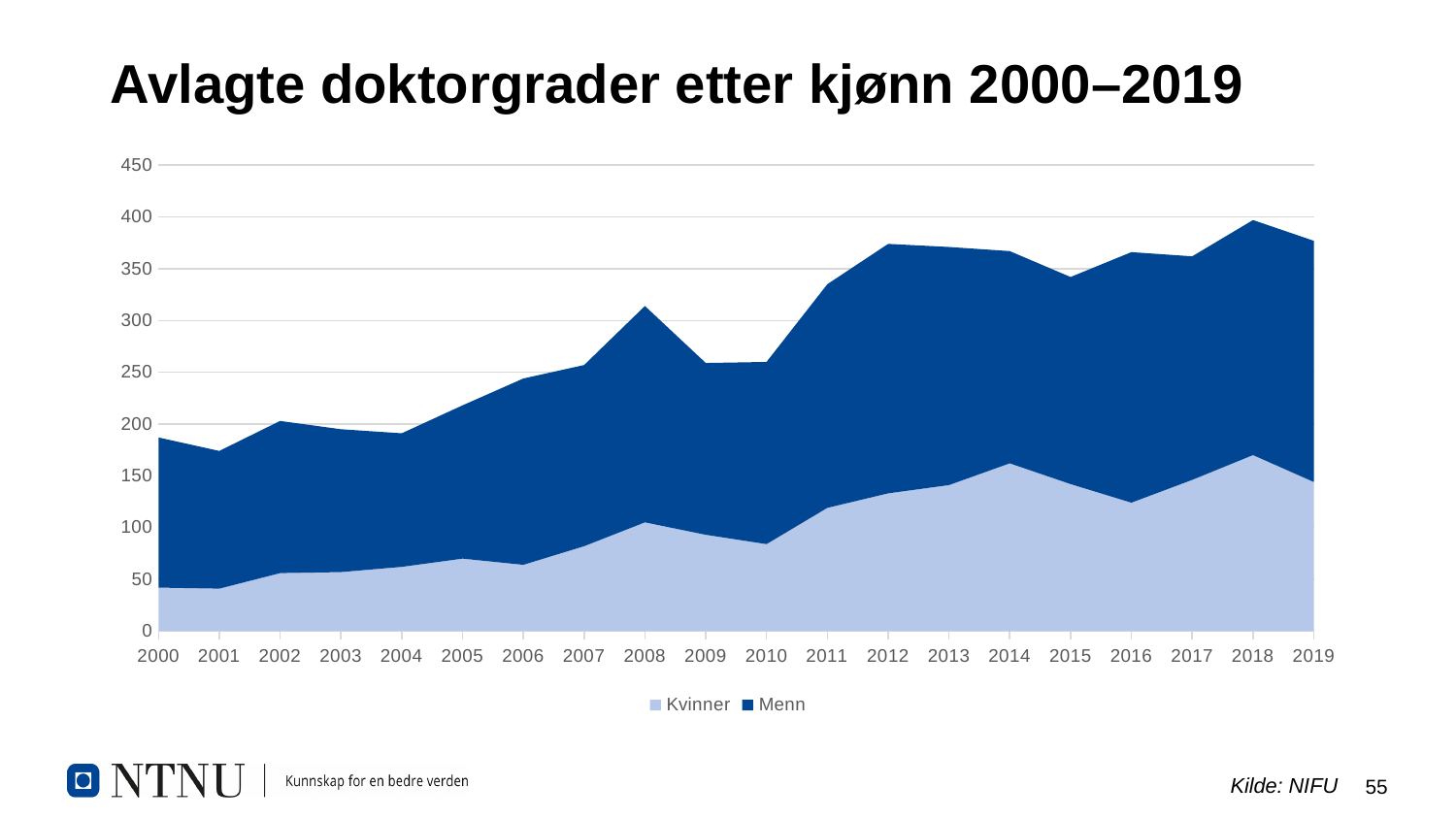
Is the value for Kvinner in 2018 greater or less than 150? greater How many years are shown along the x axis? 20 In which year is the total number of doctorates lowest? 2001 Which two series are listed in the legend? Kvinner and Menn What kind of chart is shown on the slide? Stacked area chart How many series does the legend list? 2 Does the total number of doctorates generally rise or fall from 2000 to 2019? rise What is the title of the chart? Avlagte doktorgrader etter kjønn 2000–2019 In which year is the total number of doctorates (Kvinner plus Menn) highest? 2018 Is the total value for 2018 greater or less than 350? greater Is the value for Kvinner in 2000 greater or less than 50? less Which year has the larger total number of doctorates, 2010 or 2012? 2012